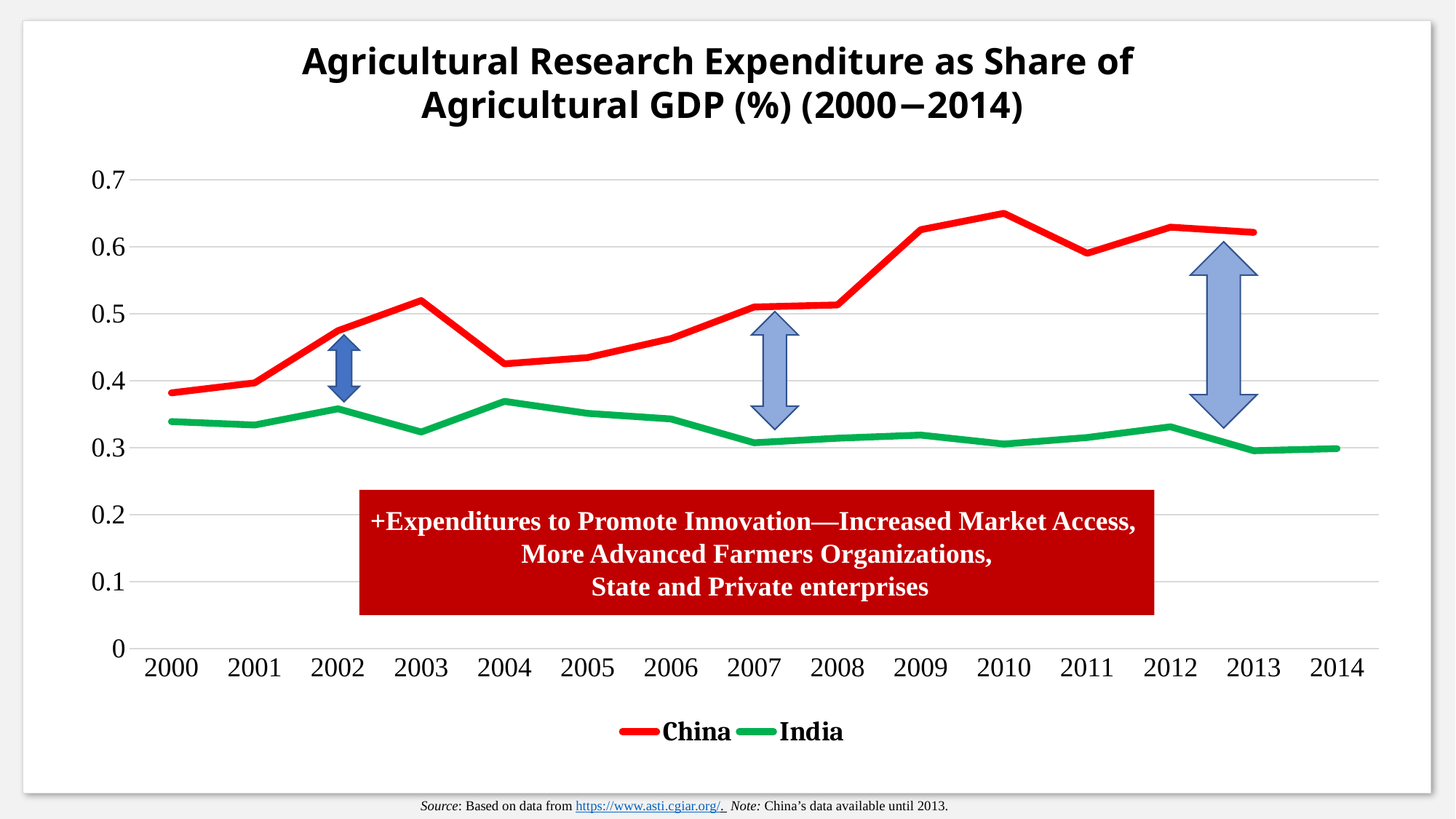
Which series is drawn in red? China Which series has the larger value in 2010, China or India? China Is the value for China in 2010 greater or less than 0.6? greater Is the value for China in 2003 greater or less than 0.5? greater What colour is the line for India? green Is the value for India in 2007 greater or less than 0.4? less How many series does the legend list? 2 In which year does China reach its highest value? 2010 What kind of chart is shown on the slide? line chart How many years are shown on the x axis? 15 Does the China line rise or fall between 2004 and 2010? rise